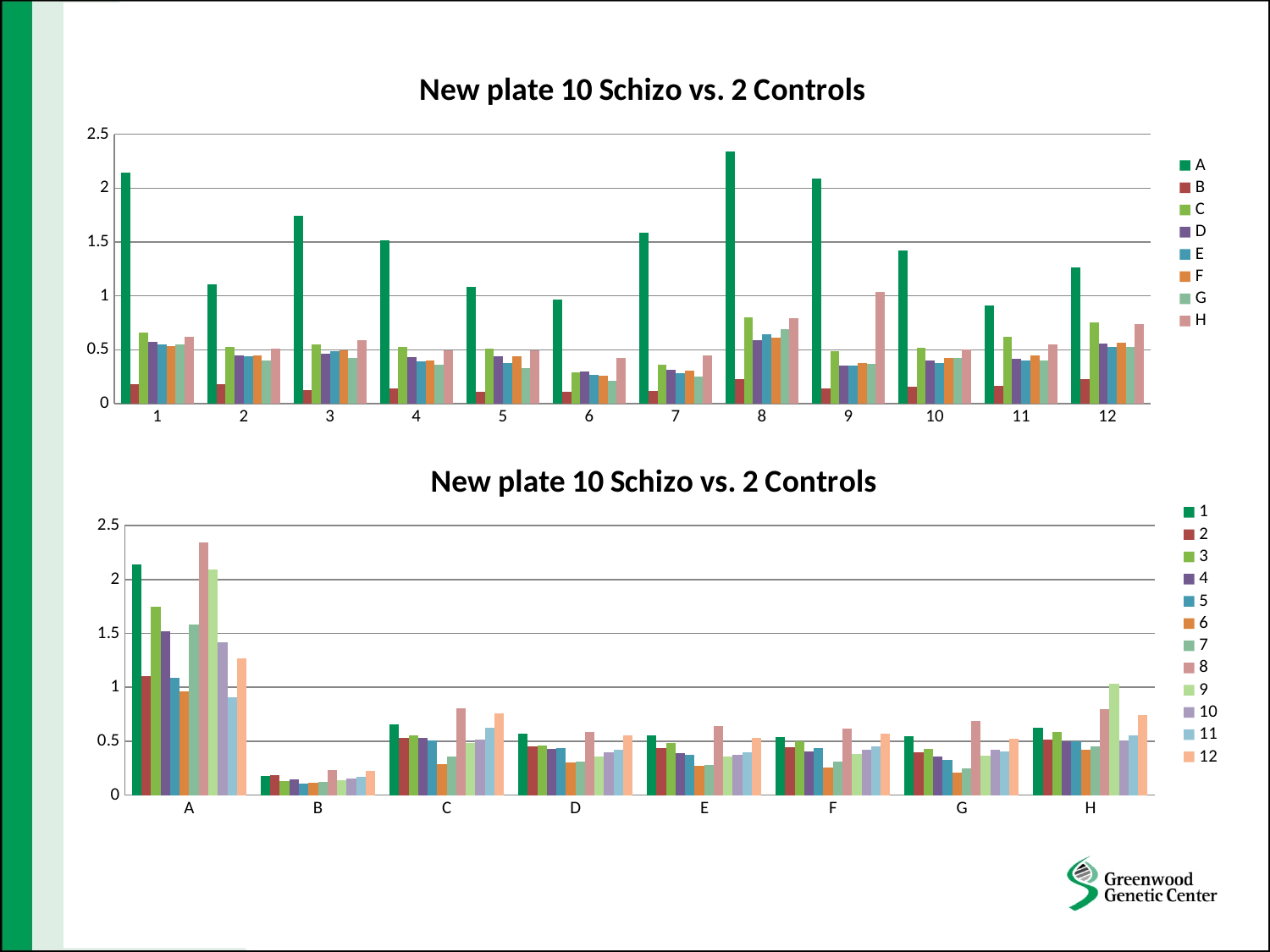
How many series does the legend of the top chart list? 8 What type of chart is the top chart on the slide? bar chart In the top chart, which series has the lowest value for category 1? B In the top chart, for category 9, which is larger: series A or series H? A In the top chart, is the value of series A for category 8 greater or less than 2? greater In the top chart, is the value of series A for category 3 greater or less than 1.5? greater How many categories are shown on the x axis of the top chart? 12 How many categories are shown on the x axis of the bottom chart? 8 What is the title of the bottom chart? New plate 10 Schizo vs. 2 Controls In the top chart, is the value of series A for category 11 greater or less than 1? less How many series does the legend of the bottom chart list? 12 In the top chart, which category has the highest value for series A? 8